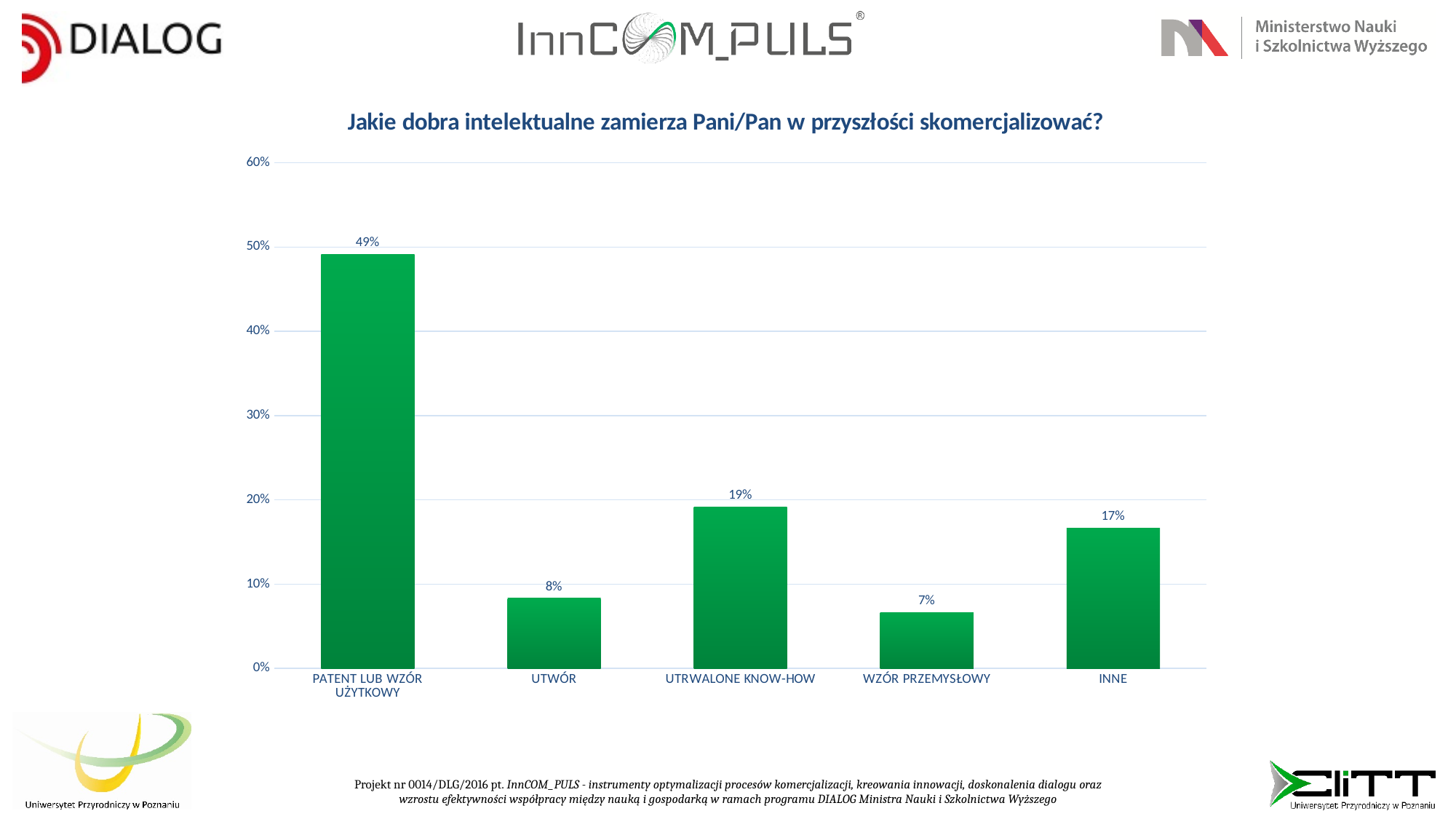
Is the value for PATENT LUB WZÓR UŻYTKOWY greater or less than 40%? greater What is the value for INNE? 17% What is the value for UTRWALONE KNOW-HOW? 19% What is the value for PATENT LUB WZÓR UŻYTKOWY? 49% What kind of chart is shown on the slide? bar chart What is the title of the chart? Jakie dobra intelektualne zamierza Pani/Pan w przyszłości skomercjalizować? Which category has the highest value? PATENT LUB WZÓR UŻYTKOWY Which is larger, the value for UTRWALONE KNOW-HOW or the value for INNE? UTRWALONE KNOW-HOW Which category has the lowest value? WZÓR PRZEMYSŁOWY What is the difference between the values for PATENT LUB WZÓR UŻYTKOWY and UTRWALONE KNOW-HOW? 30% How many categories are shown on the x axis? 5 What is the value for UTWÓR? 8%